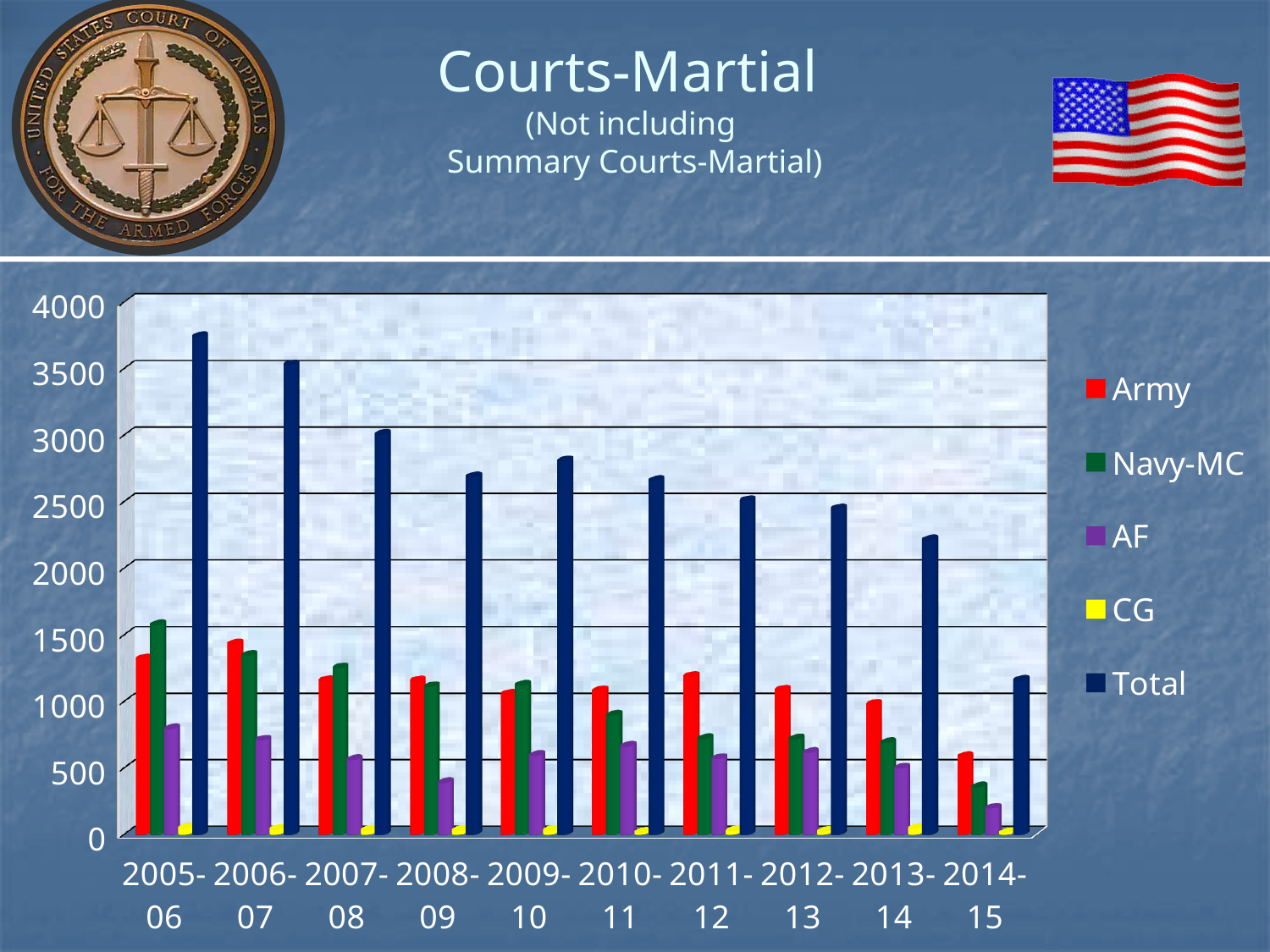
How many series does the legend list? 5 Is the Army value for 2014-15 greater or less than 1000? less In which year is the Total value lowest? 2014-15 Is the Total value for 2014-15 greater or less than 1500? less How many year categories are shown on the x axis? 10 Do the Total values generally rise or fall from 2005-06 to 2014-15? fall In which year is the Total value highest? 2005-06 In 2005-06, which is larger, the Army value or the Navy-MC value? Navy-MC Is the Total value for 2005-06 greater or less than 3500? greater What colour represents the Total series in the legend? dark blue Which series has the lowest value in 2005-06? CG What kind of chart is shown on the slide? bar chart